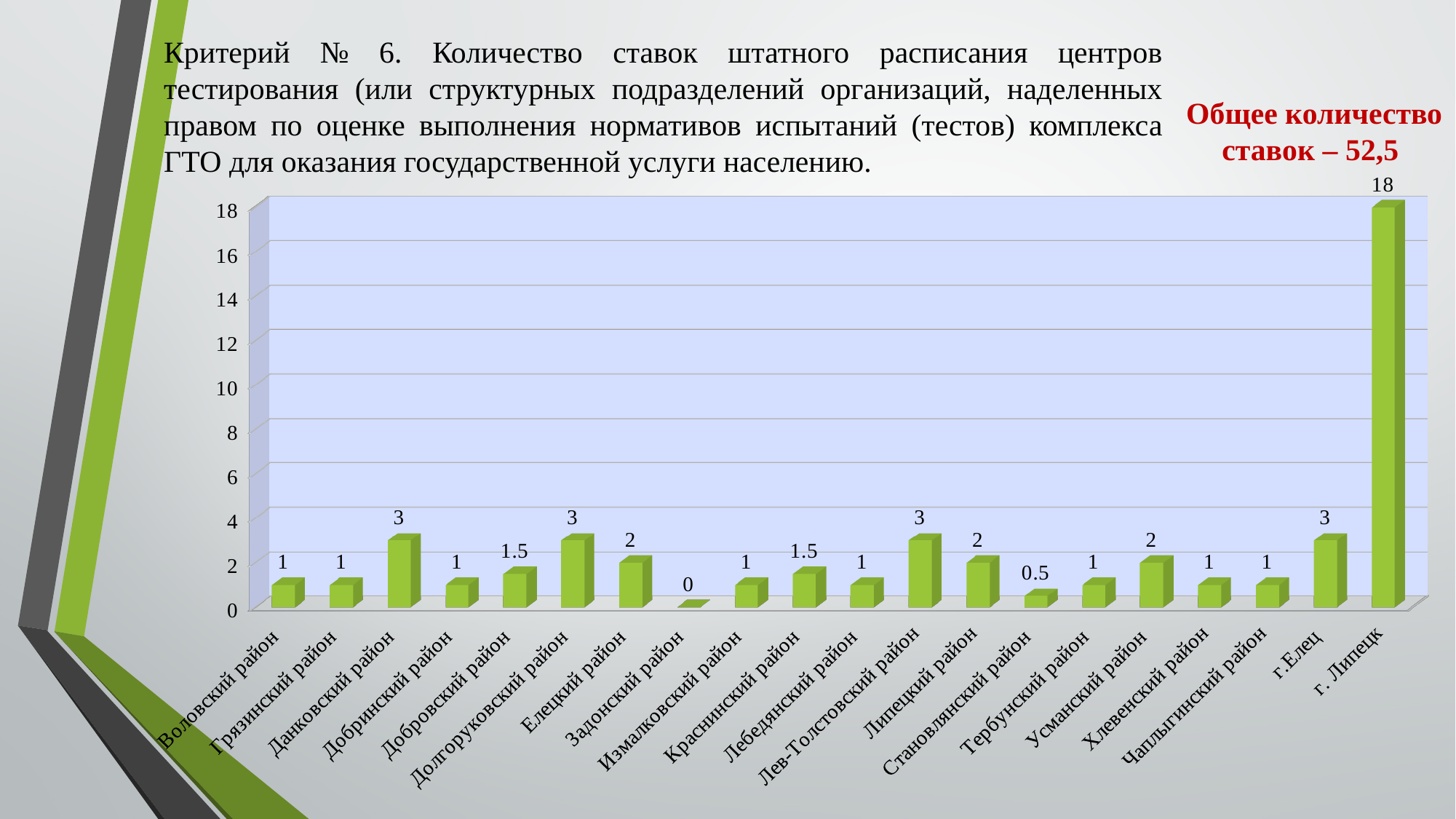
What kind of chart is shown on the slide? Bar chart What value is shown for Усманский район? 2 Which category has the lowest value? Задонский район Which is larger, the value for Липецкий район or the value for Лев-Толстовский район? Лев-Толстовский район What total number of ставок is stated in red text on the slide? 52,5 What value is shown for Добровский район? 1.5 What value is shown for Становлянский район? 0.5 What is the difference between the values for г. Липецк and г.Елец? 15 What is the difference between the values for Данковский район and Елецкий район? 1 What value is shown for г. Липецк? 18 Which category has the highest value? г. Липецк How many categories are shown on the x axis? 20